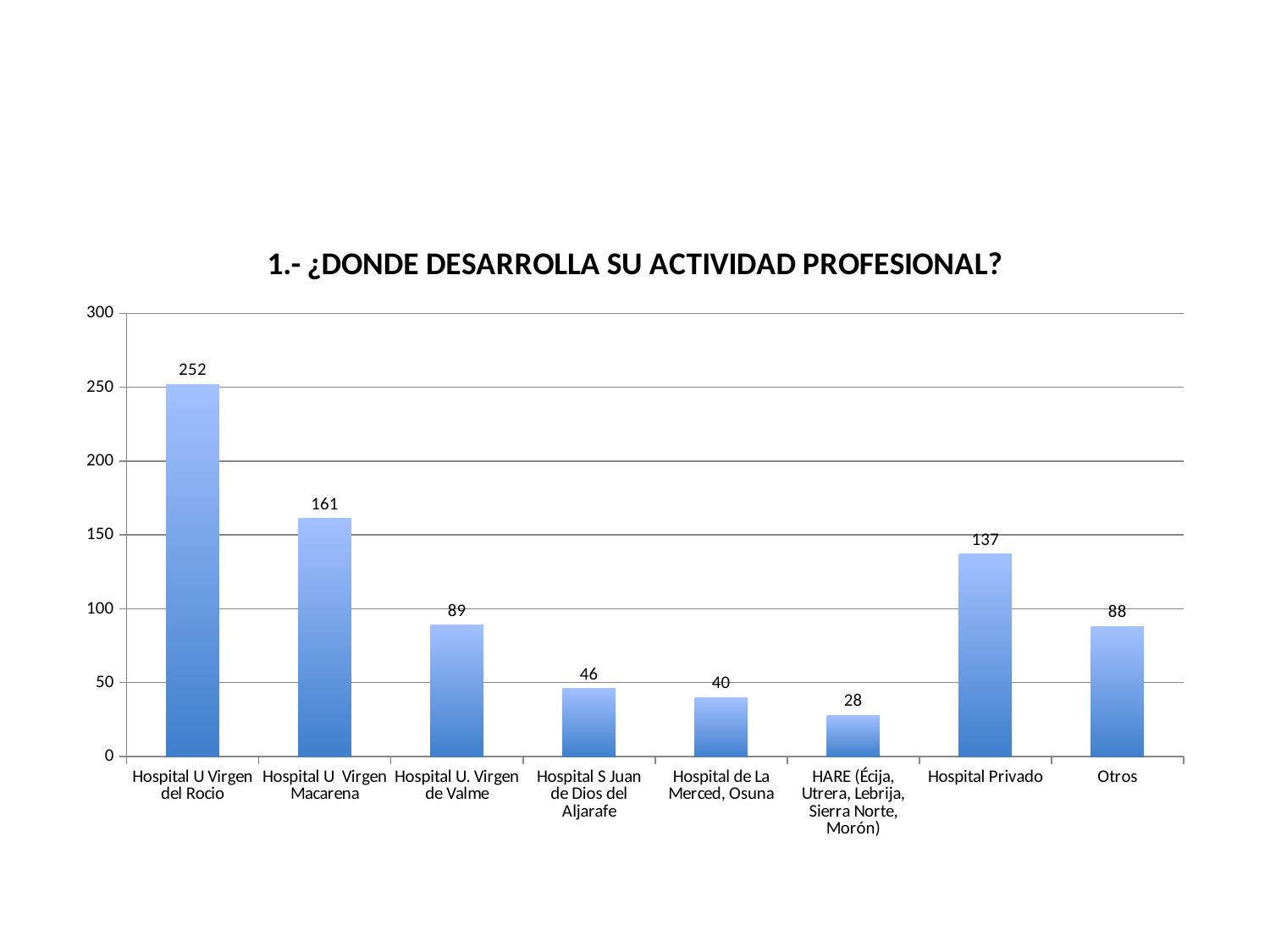
Which is larger, the value for Hospital U. Virgen de Valme or the value for Otros? Hospital U. Virgen de Valme What is the difference between the values for Hospital U Virgen del Rocio and Hospital U Virgen Macarena? 91 What is the title of the chart? 1.- ¿DONDE DESARROLLA SU ACTIVIDAD PROFESIONAL? How many categories are shown on the x axis? 8 What is the value for Otros? 88 What is the value for HARE (Écija, Utrera, Lebrija, Sierra Norte, Morón)? 28 What kind of chart is shown on the slide? Bar chart Which category has the highest value? Hospital U Virgen del Rocio Is the value for Hospital Privado greater or less than 100? greater What is the value for Hospital U Virgen del Rocio? 252 Which category has the lowest value? HARE (Écija, Utrera, Lebrija, Sierra Norte, Morón) What is the value for Hospital Privado? 137